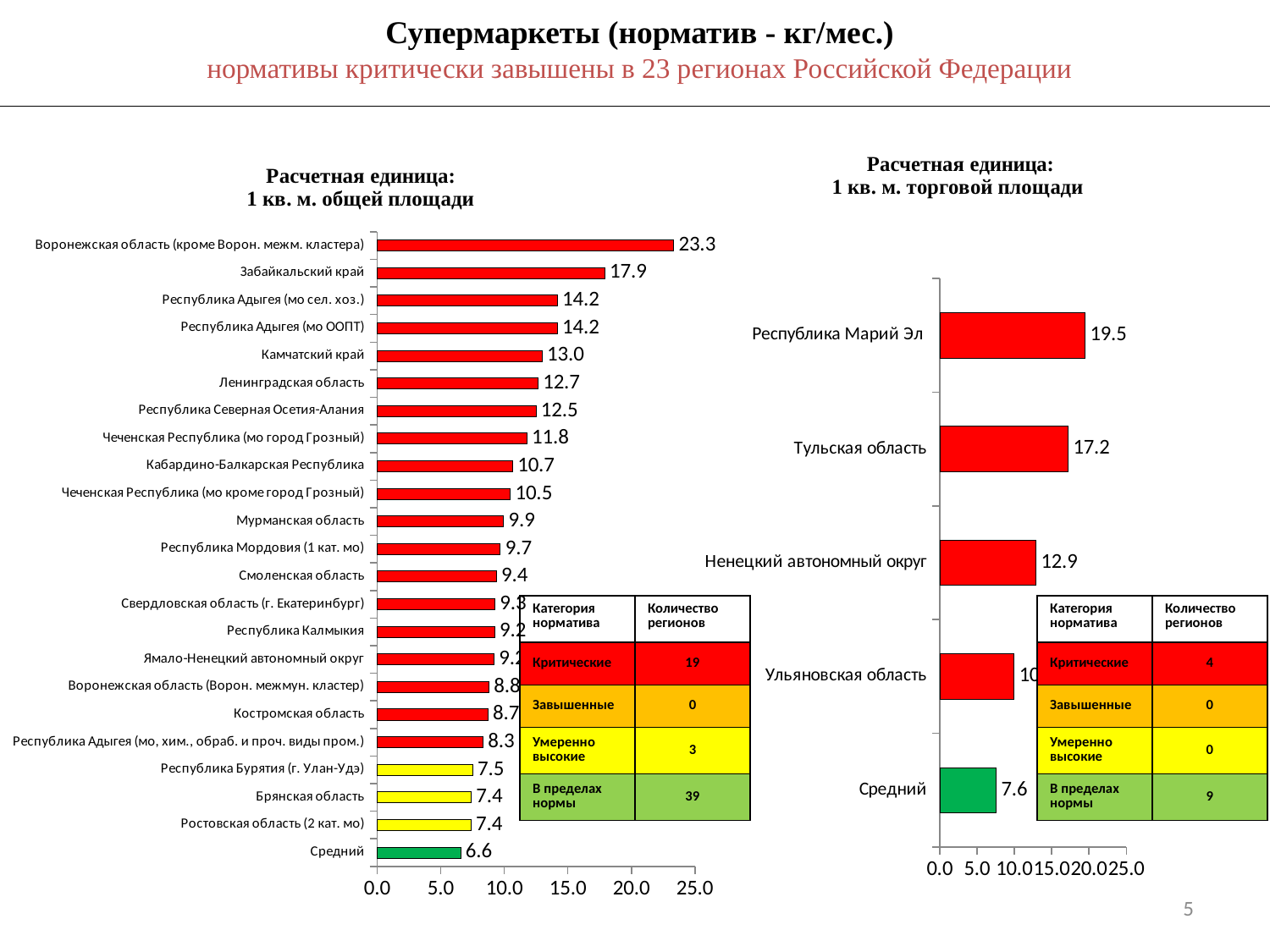
What type of chart is the left chart (1 кв. м. общей площади)? Bar chart On the right chart (1 кв. м. торговой площади), what is the difference between Республика Марий Эл and Ненецкий автономный округ? 6.6 On the left chart (1 кв. м. общей площади), what is the value for Забайкальский край? 17.9 On the right chart (1 кв. м. торговой площади), what is the value for Тульская область? 17.2 On the left chart (1 кв. м. общей площади), what is the difference between Камчатский край and Ленинградская область? 0.3 On the right chart (1 кв. м. торговой площади), which category has the lowest value? Средний On the left chart (1 кв. м. общей площади), which is larger: Мурманская область or Кабардино-Балкарская Республика? Кабардино-Балкарская Республика On the right chart (1 кв. м. торговой площади), is the value for Ульяновская область greater or less than 15.0? less On the left chart (1 кв. м. общей площади), what is the value for Средний? 6.6 On the left chart (1 кв. м. общей площади), which category has the highest value? Воронежская область (кроме Ворон. межм. кластера) On the right chart (1 кв. м. торговой площади), what is the value for Республика Марий Эл? 19.5 On the left chart (1 кв. м. общей площади), how many bars are plotted? 23